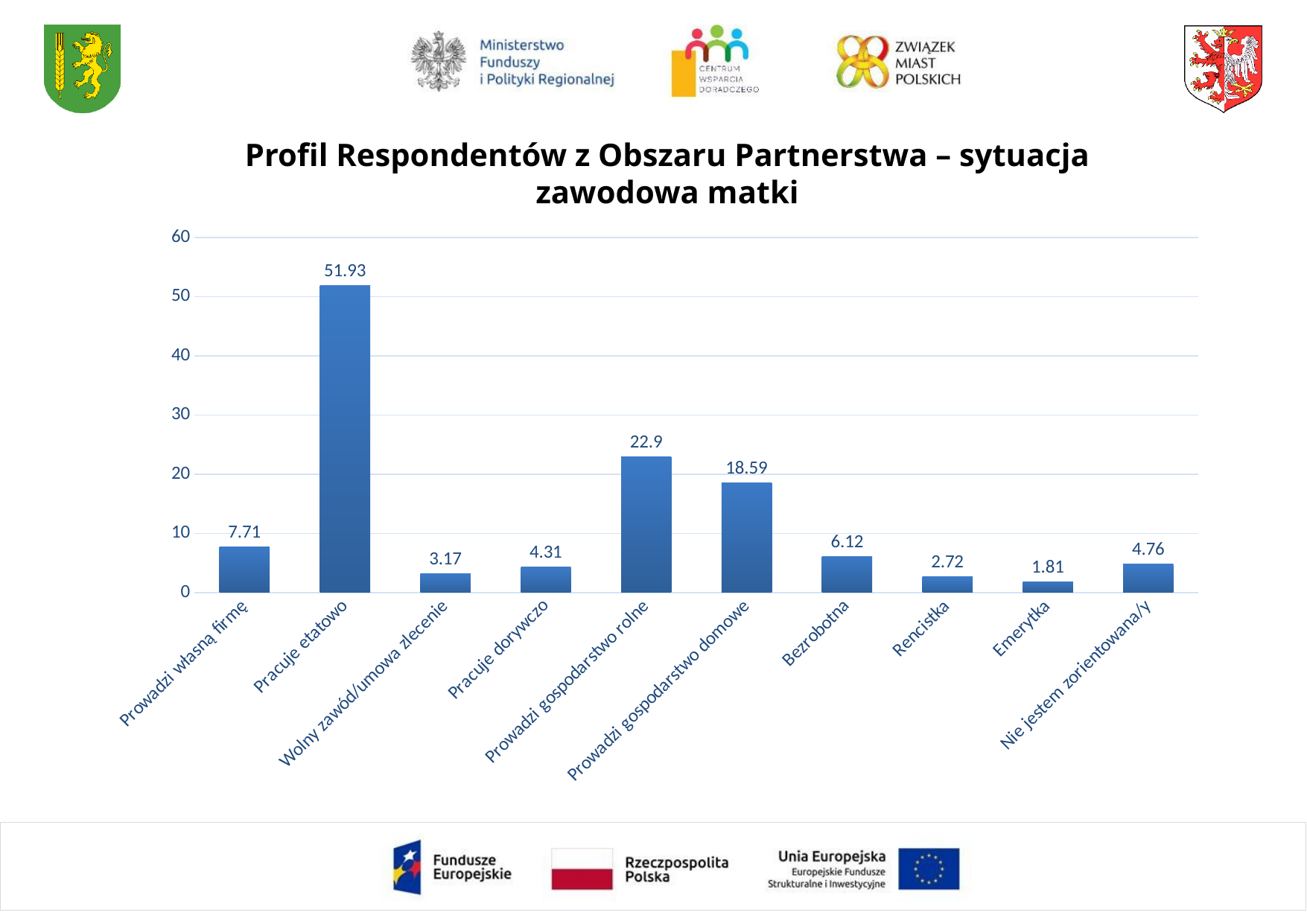
What is the difference between the values for "Pracuje etatowo" and "Prowadzi gospodarstwo rolne"? 29.03 Which category has the highest value? Pracuje etatowo Is the value for "Prowadzi gospodarstwo rolne" greater or less than 20? greater How many categories are shown on the x axis? 10 Which category has the lowest value? Emerytka What kind of chart is shown on the slide? bar chart What is the difference between the values for "Prowadzi gospodarstwo rolne" and "Prowadzi gospodarstwo domowe"? 4.31 What is the title of the chart? Profil Respondentów z Obszaru Partnerstwa – sytuacja zawodowa matki What is the value for "Bezrobotna"? 6.12 Which is larger, the value for "Prowadzi własną firmę" or the value for "Nie jestem zorientowana/y"? Prowadzi własną firmę What is the value for "Prowadzi gospodarstwo domowe"? 18.59 What is the value for "Pracuje etatowo"? 51.93